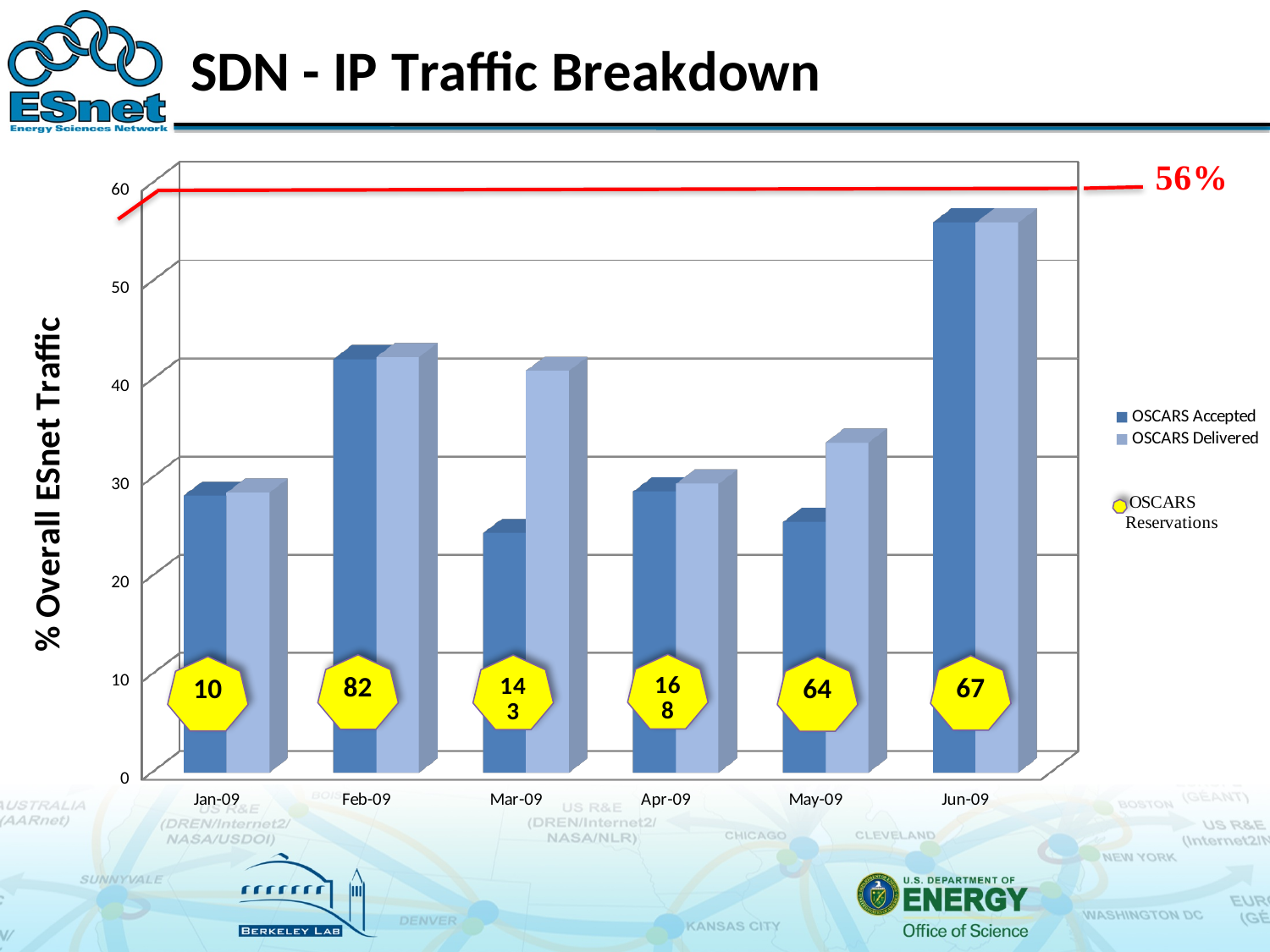
How many more OSCARS Reservations were there in Apr-09 than in Mar-09? 25 What is the number of OSCARS Reservations shown for Feb-09? 82 How many months are shown along the x axis of the chart? 6 Is the OSCARS Accepted value for Mar-09 greater or less than 30? less What percentage is labelled on the red line at the top of the chart? 56% What kind of chart is shown on the slide? bar chart For Mar-09, which is larger: OSCARS Accepted or OSCARS Delivered? OSCARS Delivered Which month has the lowest number of OSCARS Reservations? Jan-09 Is the OSCARS Accepted value for Jun-09 greater or less than 50? greater What is the number of OSCARS Reservations shown for Mar-09? 143 How many entries does the chart's legend list? 3 Which month has the highest number of OSCARS Reservations? Apr-09